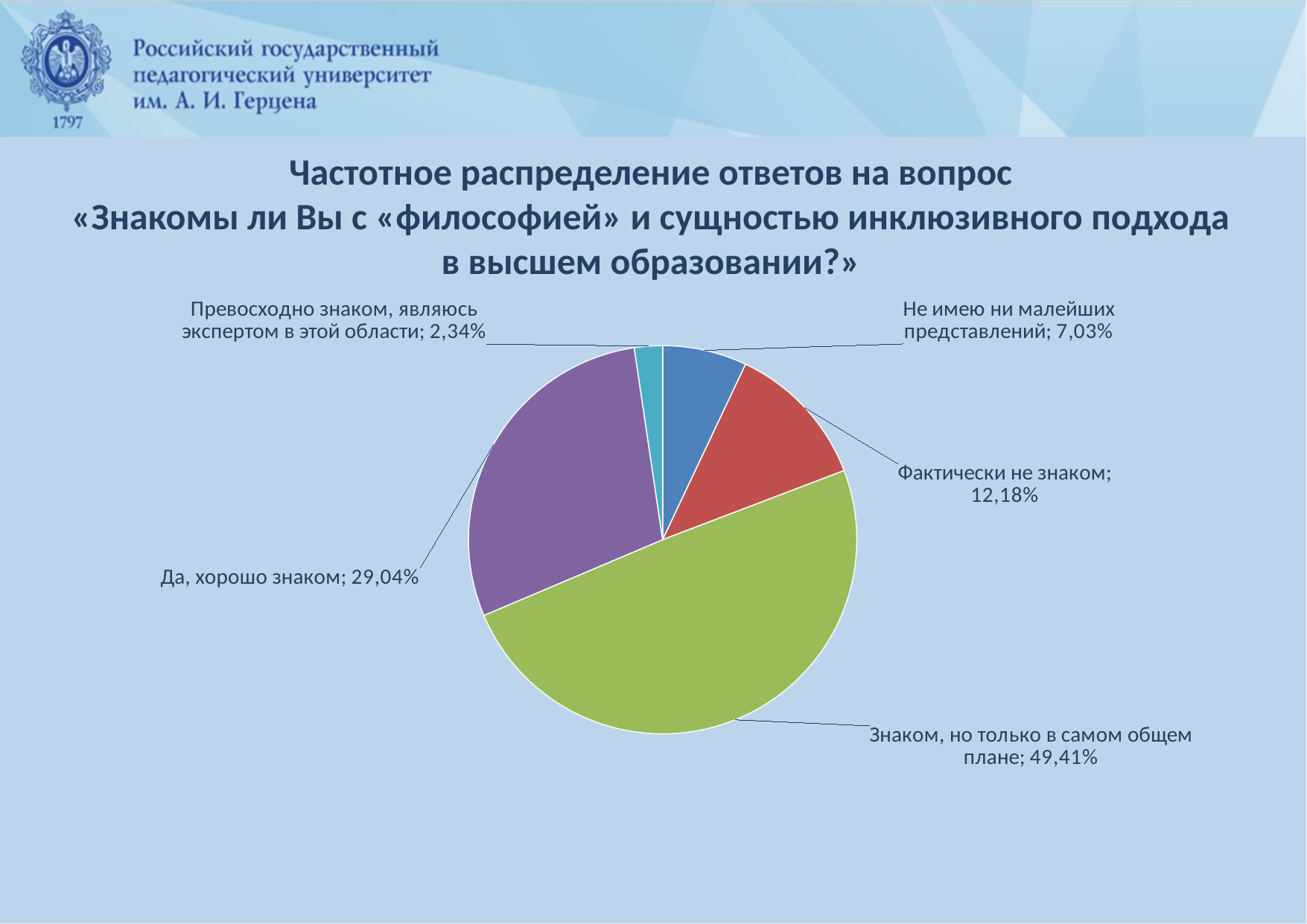
How many slices does the pie chart have? 5 Which answer option has the smallest share of the pie? Превосходно знаком, являюсь экспертом в этой области Which answer option has the largest share of the pie? Знаком, но только в самом общем плане What share of respondents answered «Знаком, но только в самом общем плане»? 49,41% What share of respondents answered «Фактически не знаком»? 12,18% What is the difference in percentage points between «Знаком, но только в самом общем плане» and «Да, хорошо знаком»? 20,37% What share of respondents answered «Не имею ни малейших представлений»? 7,03% What share of respondents answered «Да, хорошо знаком»? 29,04% What share of respondents answered «Превосходно знаком, являюсь экспертом в этой области»? 2,34% Which is larger: the share for «Фактически не знаком» or the share for «Не имею ни малейших представлений»? Фактически не знаком What type of chart is shown on the slide? pie chart What colour is the slice for «Да, хорошо знаком»? purple